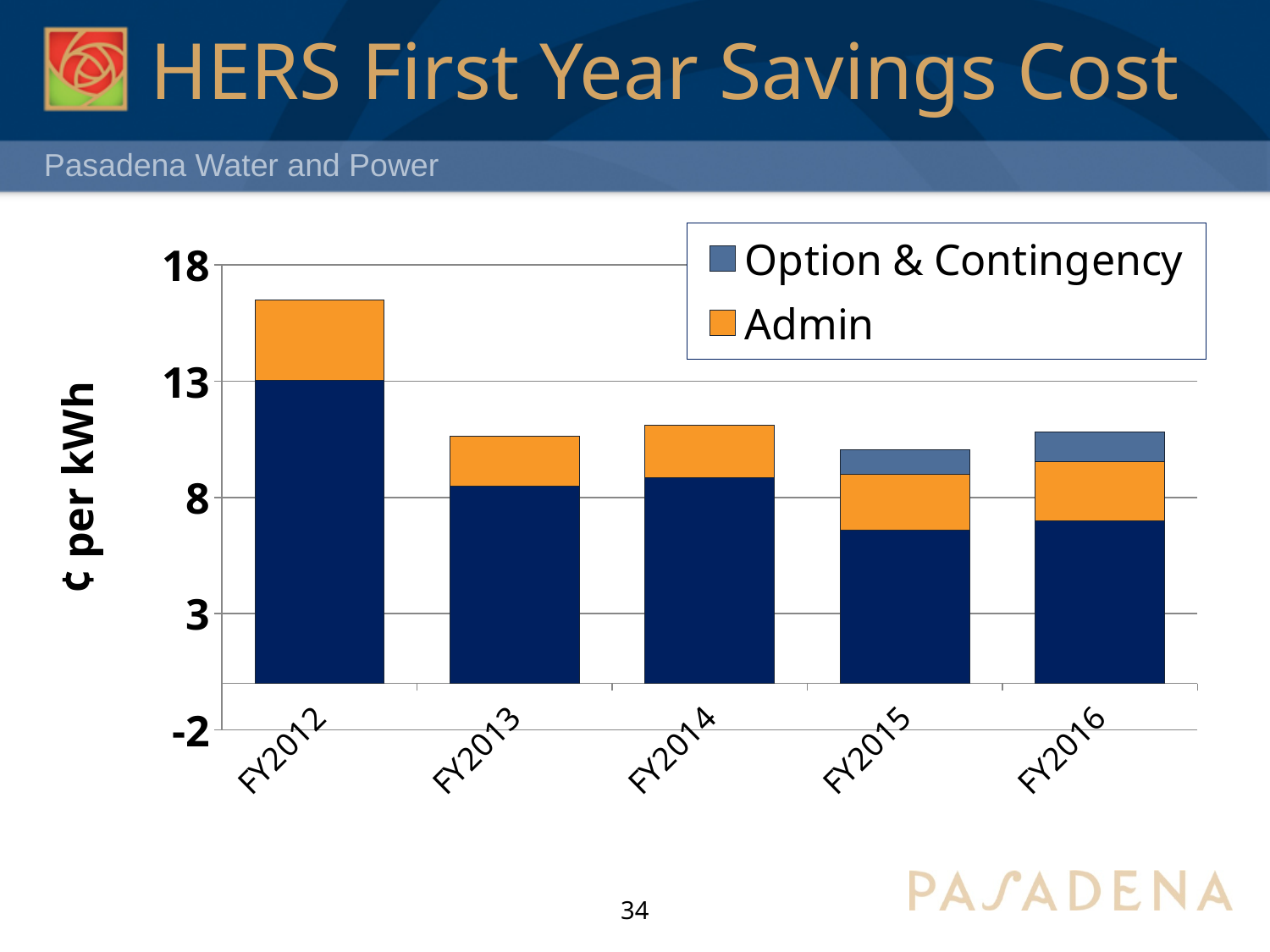
Do the total stacked values rise or fall from FY2012 to FY2013? Fall What colour represents the Admin series in the legend? Orange Is the total stacked value for FY2015 greater or less than 8? greater Is the dark blue segment for FY2015 greater or less than 8? less Which fiscal year has the tallest stacked bar? FY2012 How many fiscal years are shown on the x axis of the chart? 5 Is the total stacked value for FY2013 greater or less than 13? less How many series does the chart's legend list? 2 What kind of chart is shown on the slide? Stacked bar chart Which has the larger total stacked bar, FY2012 or FY2015? FY2012 What is the label on the chart's y axis? ¢ per kWh